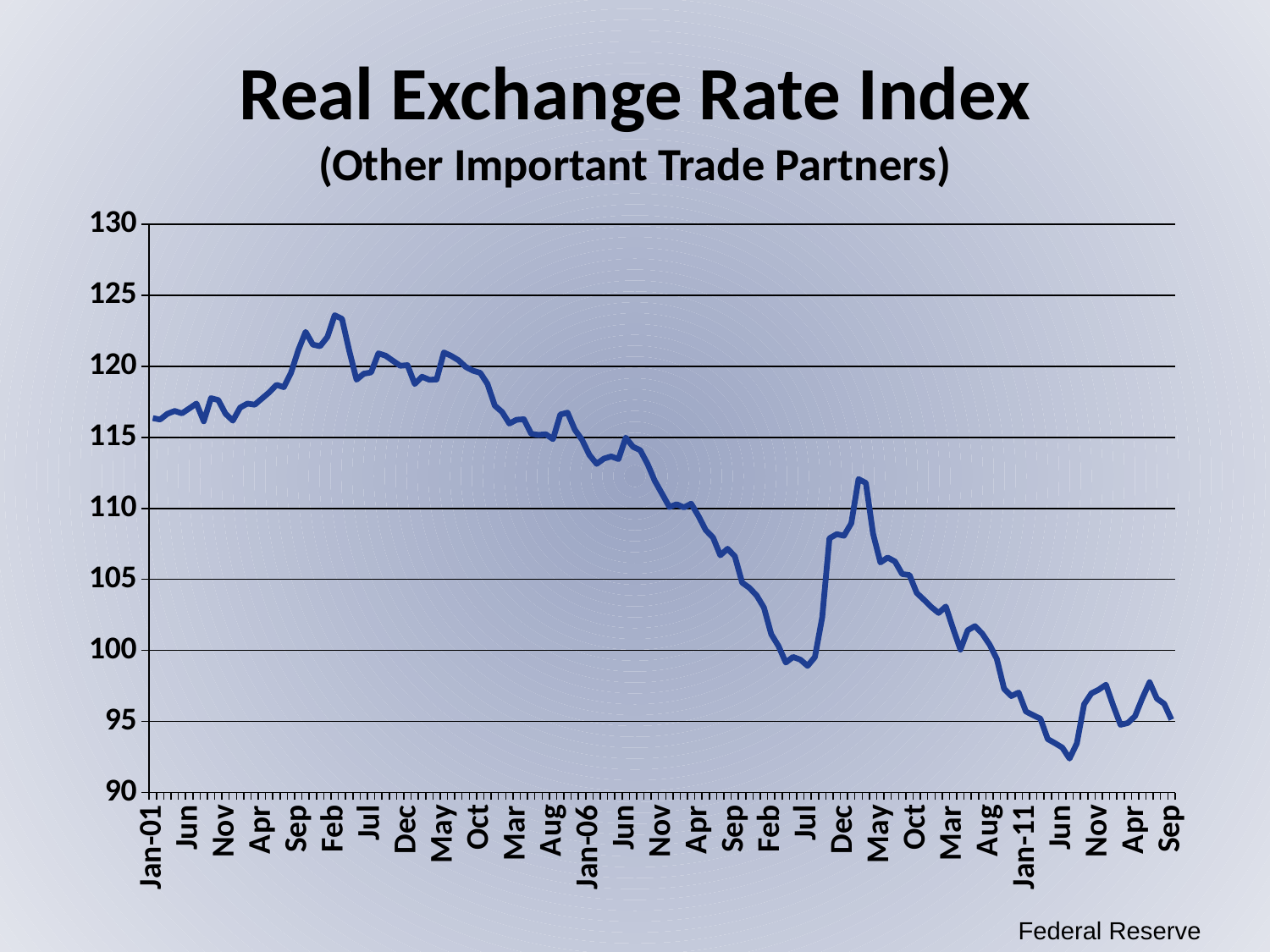
Is the value for Jan-01 greater or less than 115? greater Which is larger, the value at Jan-01 or the value at Jan-11? Jan-01 What is the title of the chart? Real Exchange Rate Index (Other Important Trade Partners) Is the value for Jan-06 greater or less than 115? less Is the lowest point of the line greater or less than 95? less Which is larger, the value at Jan-06 or the value at Jan-11? Jan-06 How many labels are shown on the x axis? 29 Overall, does the Real Exchange Rate Index rise or fall from Jan-01 to Sep (2011) along the x axis? Fall What kind of chart is shown on the slide? Line chart What source is cited at the bottom of the slide? Federal Reserve